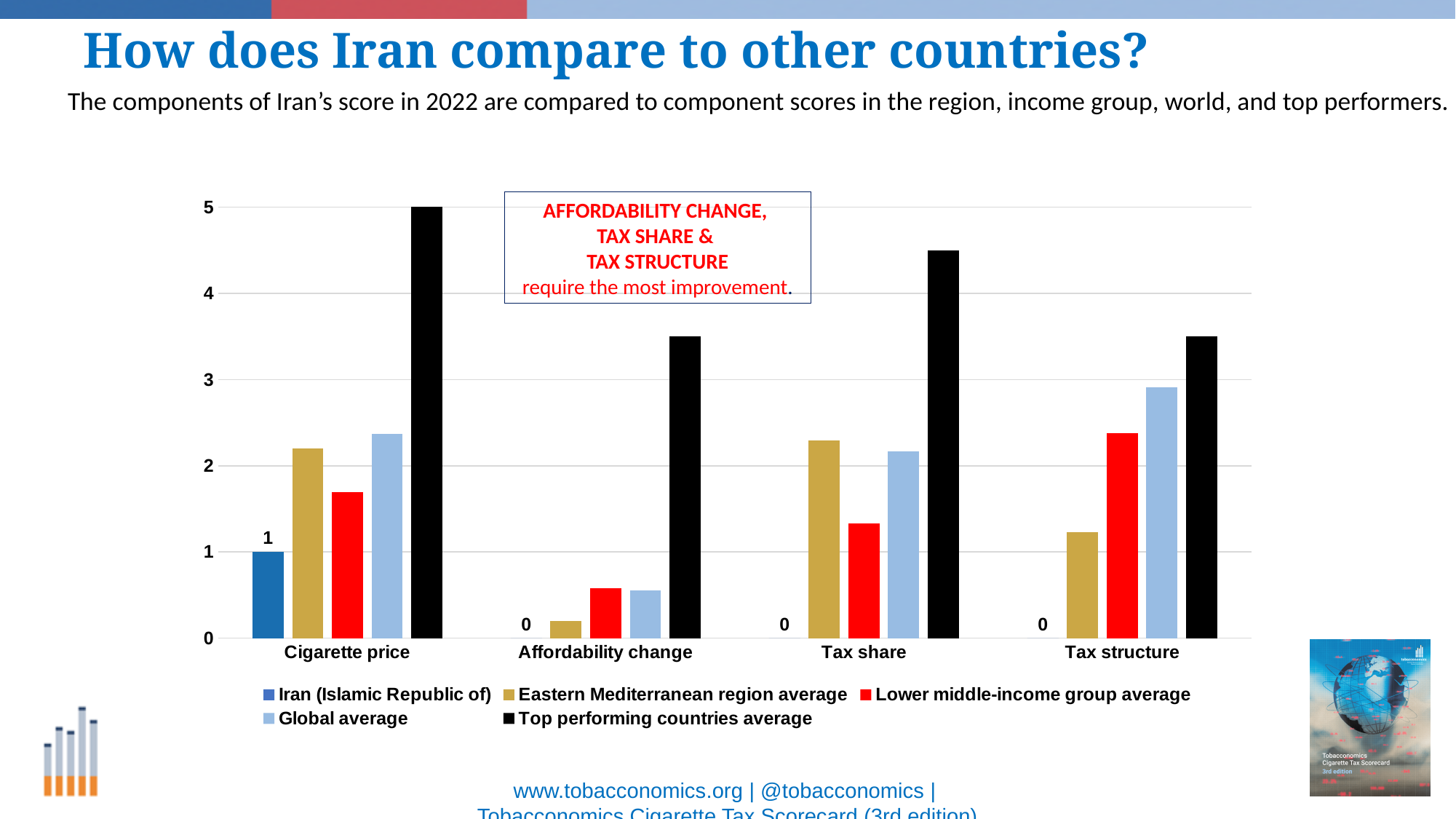
What colour represents Top performing countries average in the chart? Black How many categories are shown on the x axis of the chart? 4 Which series has the highest value in the Cigarette price category? Top performing countries average What is the value for Iran (Islamic Republic of) in the Tax share category? 0 What kind of chart is shown on the slide? Bar chart Which series has the lowest value in the Affordability change category? Iran (Islamic Republic of) How many series does the legend list? 5 Is the value for Lower middle-income group average in the Cigarette price category greater or less than 2? less What is the value for Iran (Islamic Republic of) in the Cigarette price category? 1 What is the value for Top performing countries average in the Cigarette price category? 5 In the Tax share category, which is larger: Eastern Mediterranean region average or Lower middle-income group average? Eastern Mediterranean region average Is the value for Top performing countries average in the Affordability change category greater or less than 3? greater